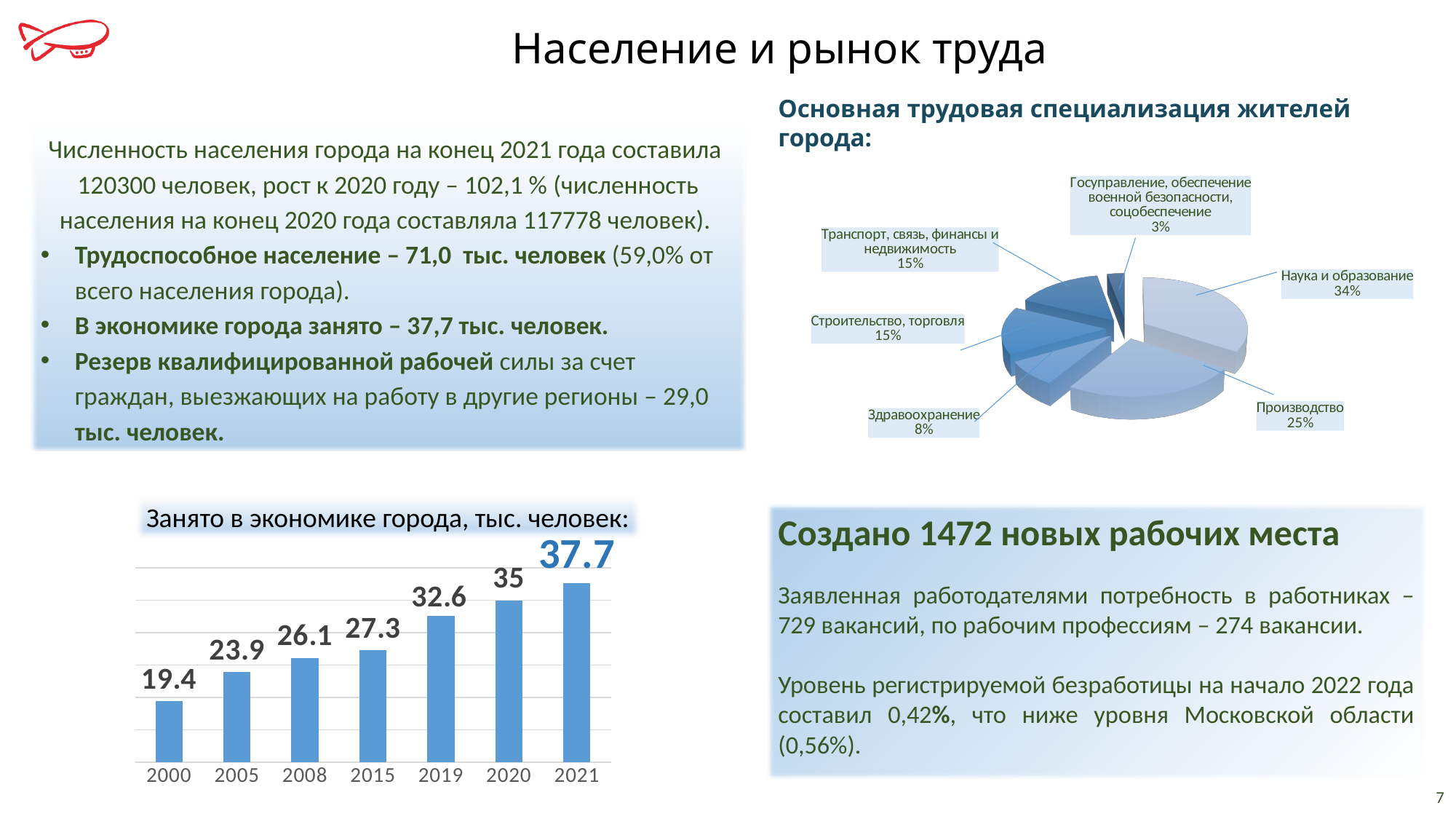
In the pie chart 'Основная трудовая специализация жителей города', how many slices are there? 6 In the bar chart 'Занято в экономике города, тыс. человек', do the values rise or fall from 2000 to 2021? rise In the pie chart 'Основная трудовая специализация жителей города', which category has the smallest share? Госуправление, обеспечение военной безопасности, соцобеспечение In the pie chart 'Основная трудовая специализация жителей города', which is larger: 'Производство' or 'Строительство, торговля'? Производство In the bar chart 'Занято в экономике города, тыс. человек', what is the difference between the values for 2021 and 2020? 2.7 What kind of chart is 'Занято в экономике города, тыс. человек'? bar chart In the bar chart 'Занято в экономике города, тыс. человек', how many years are shown on the x axis? 7 In the bar chart 'Занято в экономике города, тыс. человек', which year has the lowest value? 2000 In the bar chart 'Занято в экономике города, тыс. человек', what is the value for 2021? 37.7 In the bar chart 'Занято в экономике города, тыс. человек', what is the value for 2000? 19.4 In the pie chart 'Основная трудовая специализация жителей города', what share does 'Наука и образование' have? 34% In the pie chart 'Основная трудовая специализация жителей города', what is the value for 'Здравоохранение'? 8%